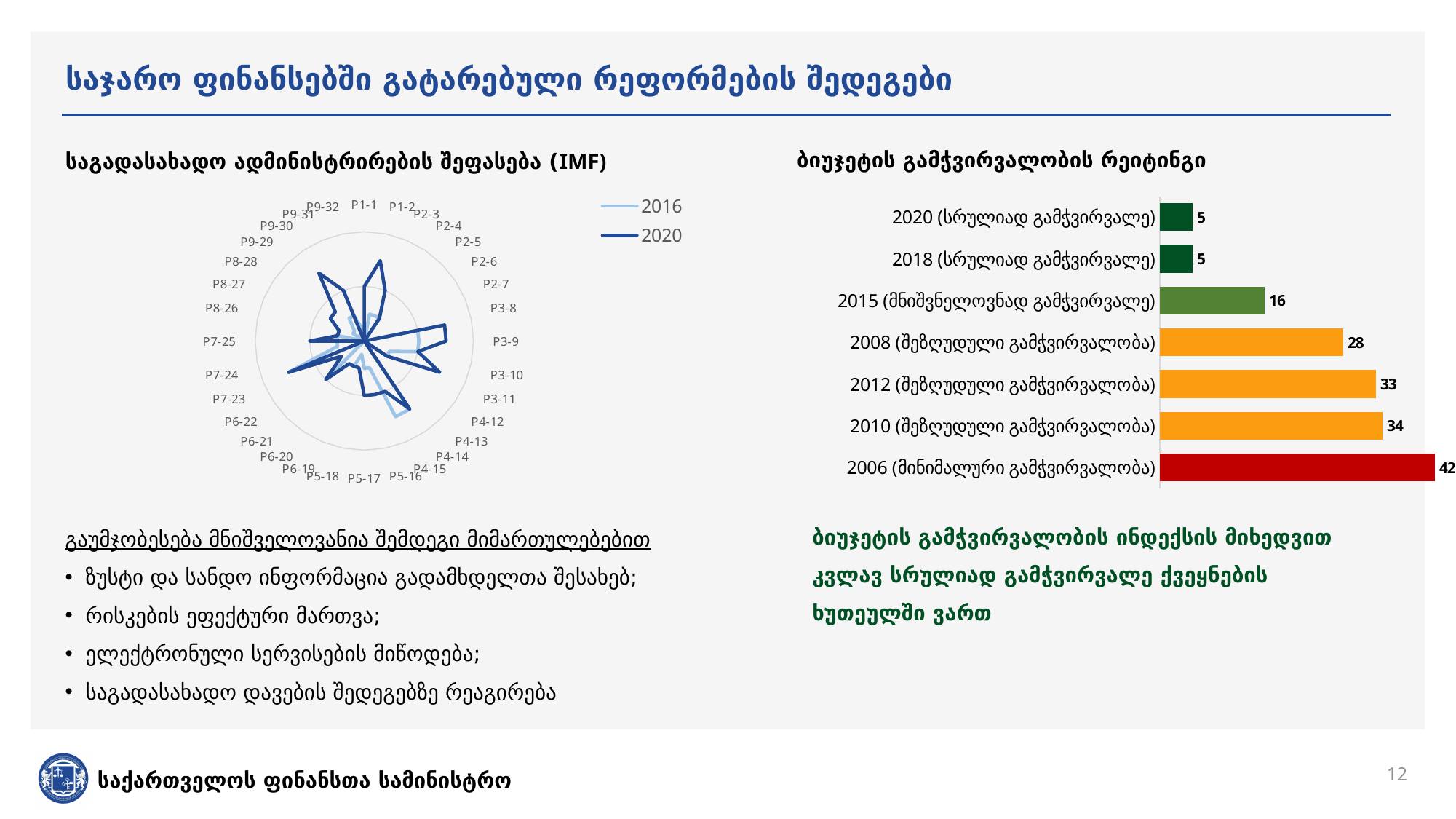
In the bar chart on the right, what is the difference between the values for 2008 and 2015? 12 In the bar chart on the right (ბიუჯეტის გამჭვირვალობის რეიტინგი), what is the value for 2006? 42 In the bar chart on the right, what is the difference between the values for 2006 and 2010? 8 How many bars are in the bar chart on the right? 7 How many series does the legend of the radar chart on the left list? 2 In the bar chart on the right, what is the value for 2012? 33 In the bar chart on the right, what is the lowest value shown? 5 What are the two legend entries of the radar chart on the left? 2016 and 2020 In the bar chart on the right, which is larger: the value for 2008 or the value for 2012? 2012 What kind of chart is the chart on the right of the slide? Bar chart In the bar chart on the right, what is the value for 2015? 16 In the bar chart on the right, which year has the highest value? 2006